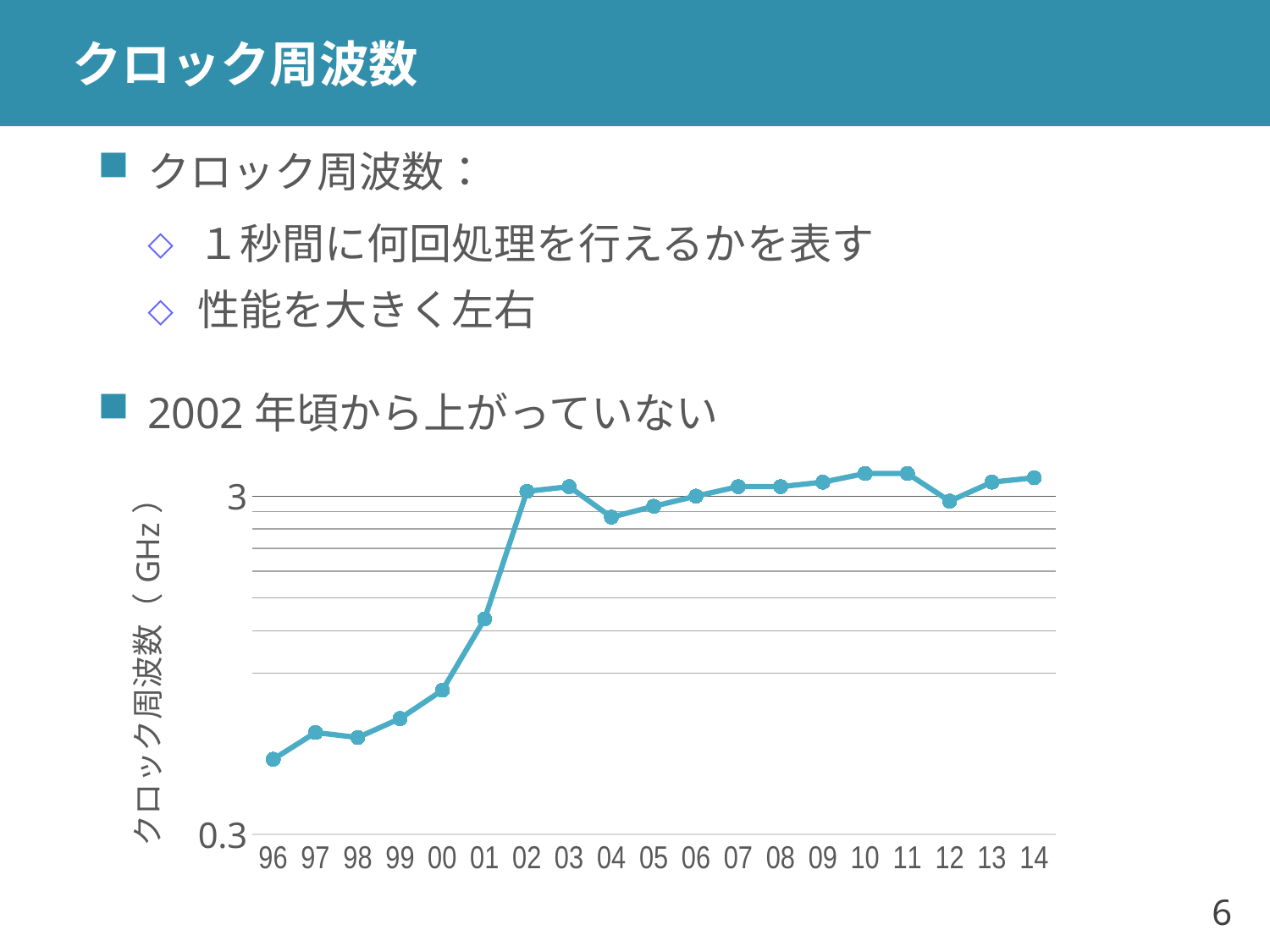
How many data points are plotted on the line chart? 19 What is the label on the y axis of the chart? クロック周波数（GHz） Is the value for 04 greater or less than 3 GHz? less Which year has the lowest clock frequency on the chart? 96 Is the value for 96 greater or less than 3 GHz? less Does the clock frequency rise or fall from 96 to 02? rise Is the value for 00 greater or less than 3 GHz? less Which has the larger clock frequency, 11 or 12? 11 Which has the larger clock frequency, 03 or 04? 03 What kind of chart is shown on the slide? line chart Which has the larger clock frequency, 96 or 02? 02